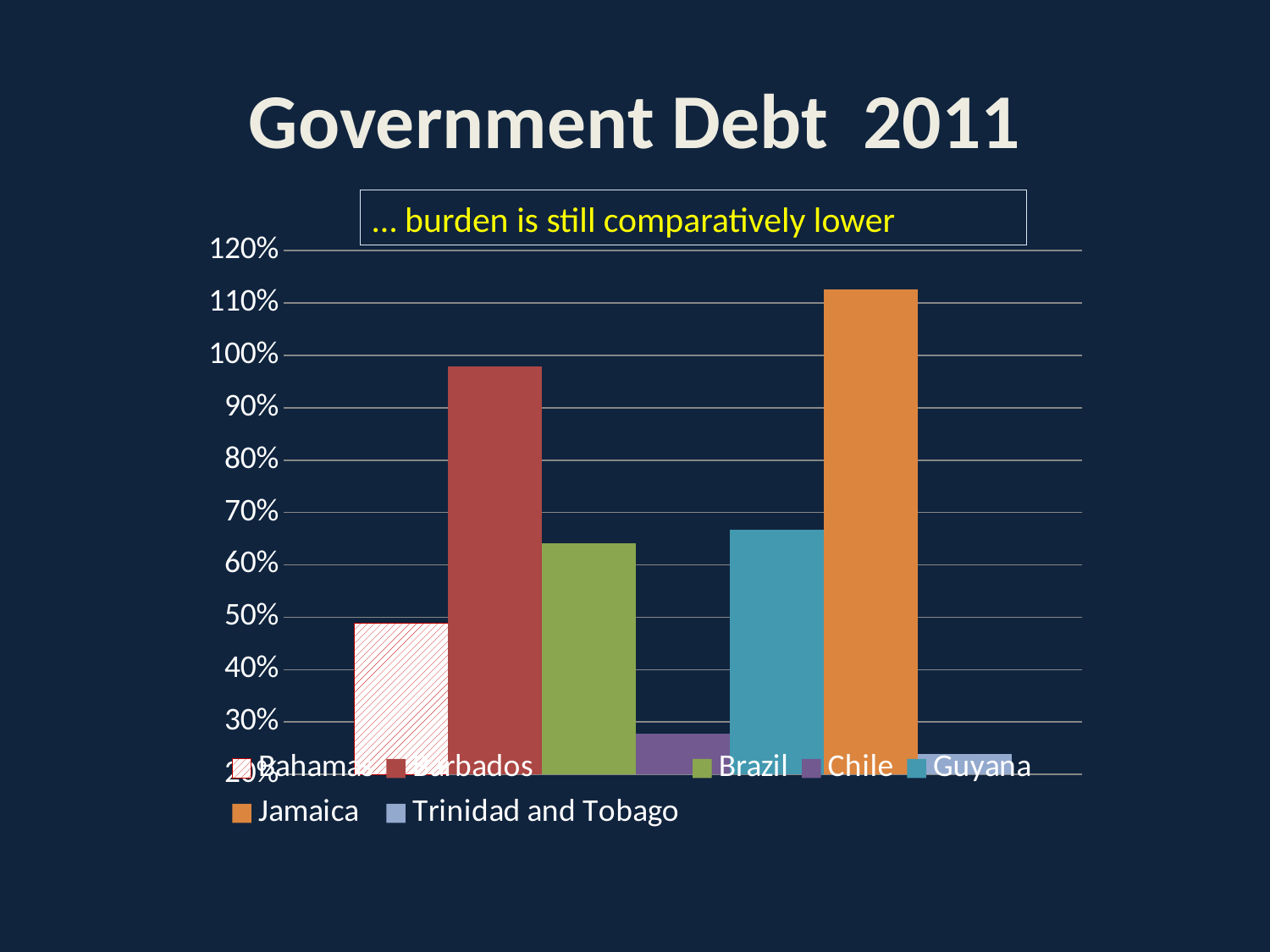
What does the text box above the chart say? ... burden is still comparatively lower Is the value for Chile greater or less than 30%? less Which country has the lowest government debt in the chart? Trinidad and Tobago What type of chart is shown on the slide? bar chart Is the value for Brazil greater or less than 60%? greater Is the value for Jamaica greater or less than 100%? greater Which is larger, the value for Barbados or the value for Brazil? Barbados How many entries does the legend list? 7 Which country has the highest government debt in the chart? Jamaica What is the title of the chart? Government Debt 2011 How many countries are shown in the chart? 7